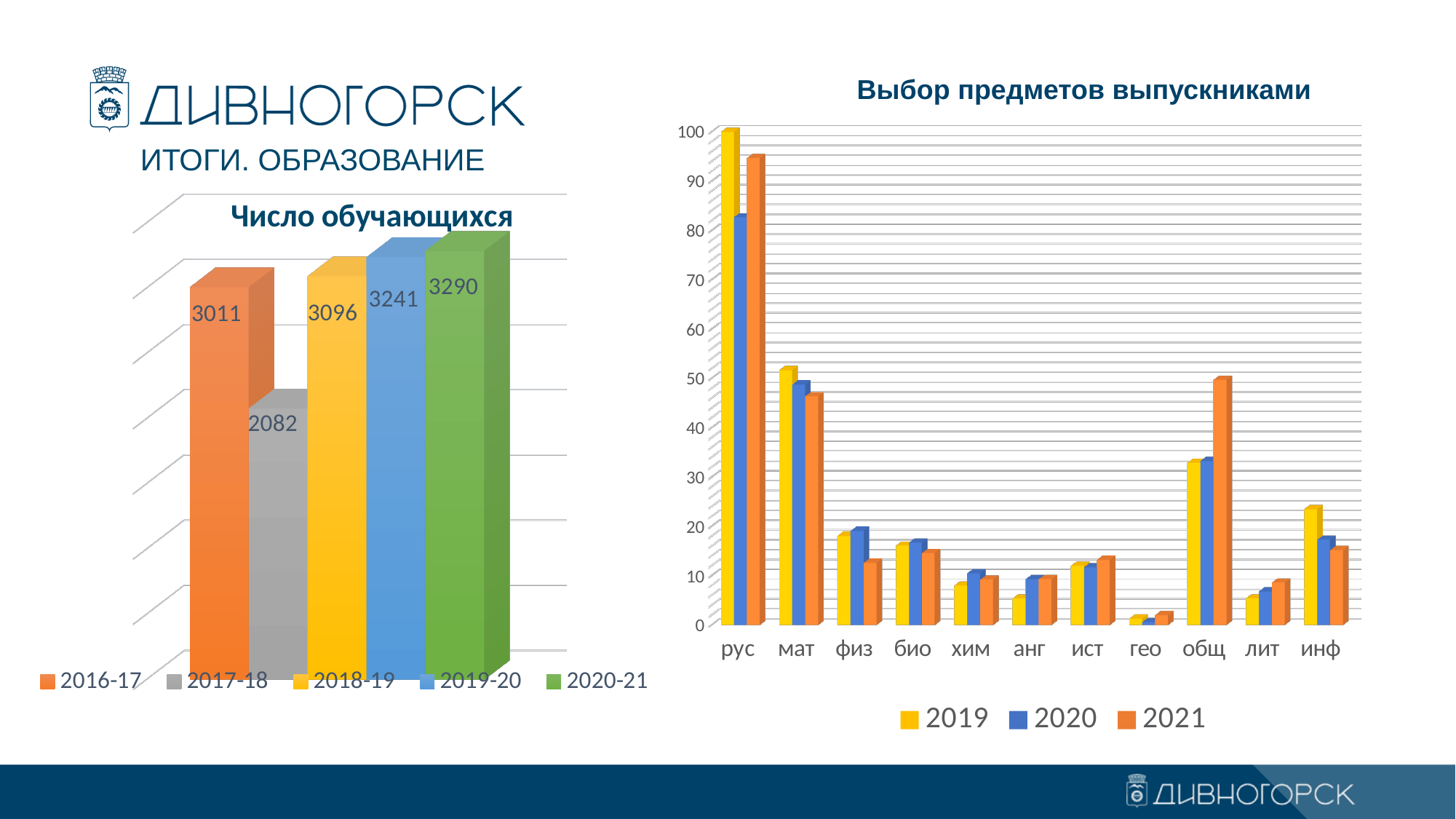
In the chart 'Выбор предметов выпускниками', is the 2021 value for общ greater or less than 40? greater In the chart 'Выбор предметов выпускниками', is the 2019 value for рус greater or less than 90? greater In the chart 'Число обучающихся', which year has the lowest value? 2017-18 In the chart 'Выбор предметов выпускниками', how many subject categories are shown on the x axis? 11 In the chart 'Число обучающихся', how many series does the legend list? 5 In the chart 'Выбор предметов выпускниками', how many series does the legend list? 3 In the chart 'Число обучающихся', what is the value for 2020-21? 3290 In the chart 'Выбор предметов выпускниками', which subject has the lowest values across all three years? гео In the chart 'Число обучающихся', what is the difference between the values for 2019-20 and 2018-19? 145 What kind of chart is 'Выбор предметов выпускниками'? bar chart In the chart 'Число обучающихся', what is the value for 2017-18? 2082 In the chart 'Число обучающихся', which year has the highest value? 2020-21